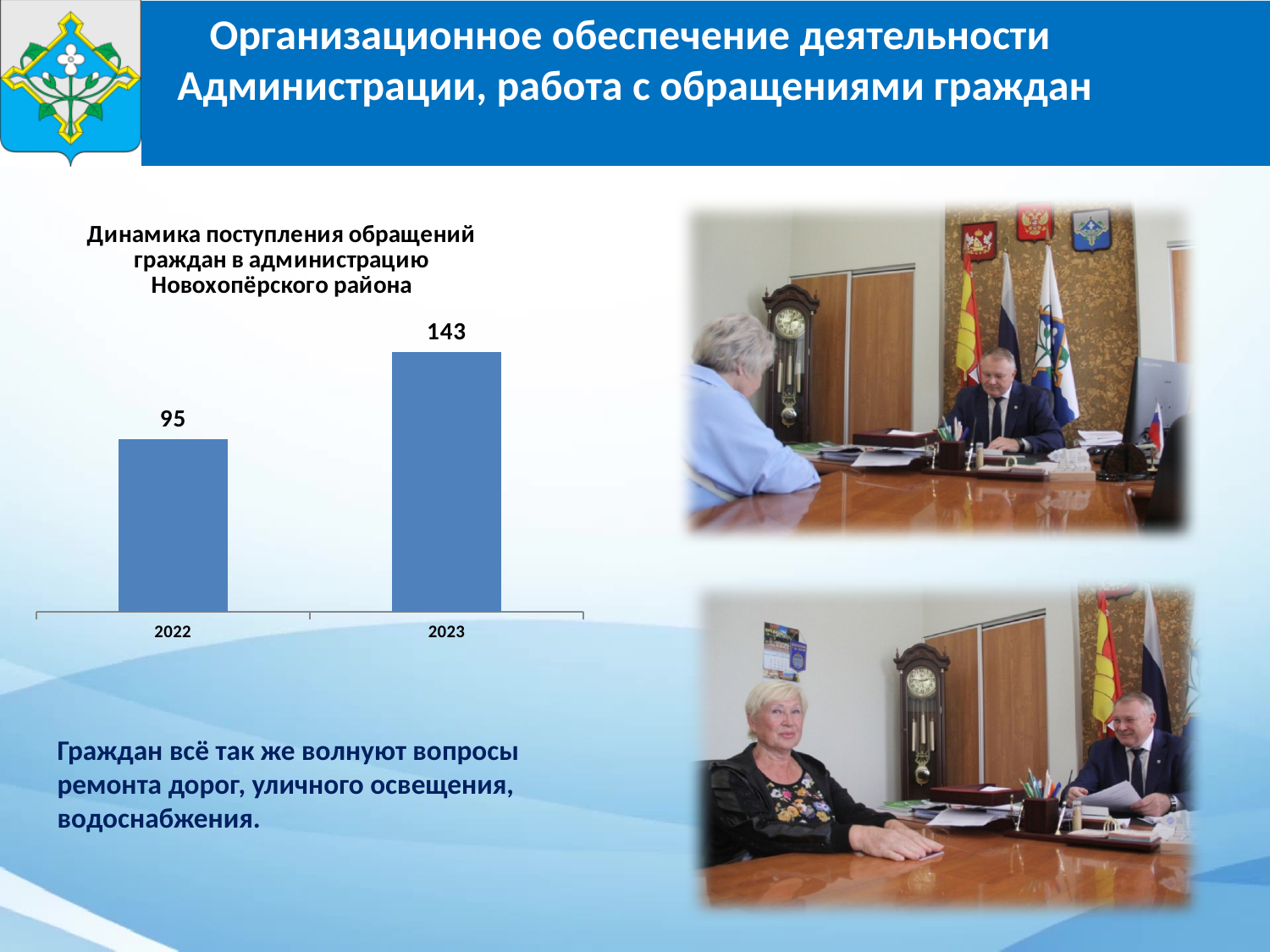
How many categories are shown in the chart? 2 Which year has the lowest value in the chart? 2022 Which is larger, the value for 2022 or the value for 2023? 2023 What is the title of the chart? Динамика поступления обращений граждан в администрацию Новохопёрского района What kind of chart is shown on the slide? Bar chart What colour are the bars in the chart? Blue What is the value for 2022 in the chart? 95 Do the values rise or fall from 2022 to 2023? Rise Which year has the highest value in the chart? 2023 What is the value for 2023 in the chart? 143 What is the difference between the values for 2023 and 2022? 48